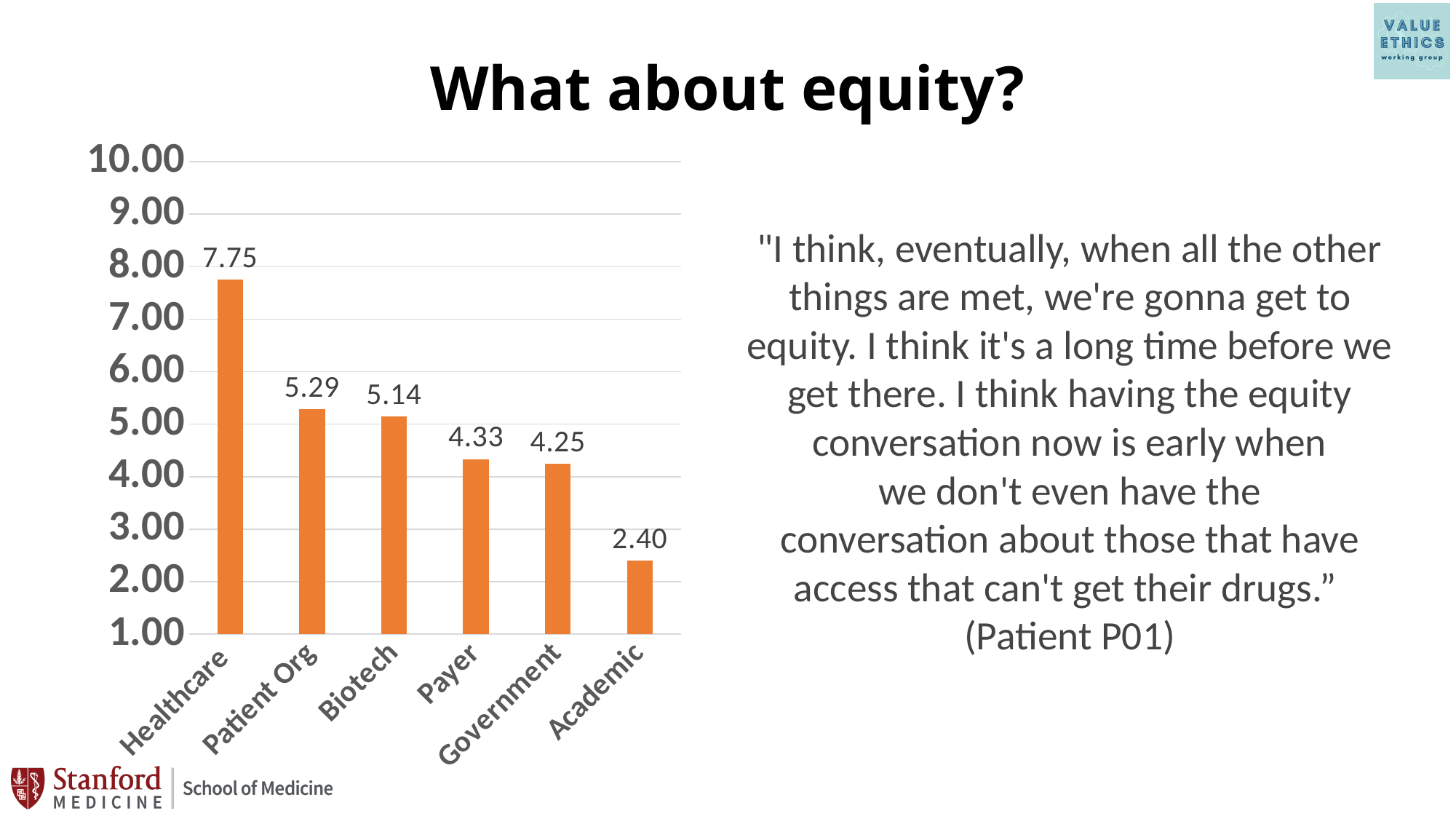
How many categories are shown on the x axis? 6 Which is larger, the value for Biotech or the value for Payer? Biotech What is the difference between the values for Healthcare and Academic? 5.35 Do the values rise or fall from left to right along the x axis? Fall What is the value for Healthcare? 7.75 Which category has the highest value? Healthcare Which category has the lowest value? Academic What is the value for Government? 4.25 What is the difference between the values for Patient Org and Biotech? 0.15 What kind of chart is shown on the slide? Bar chart What is the value for Academic? 2.40 What is the value for Patient Org? 5.29